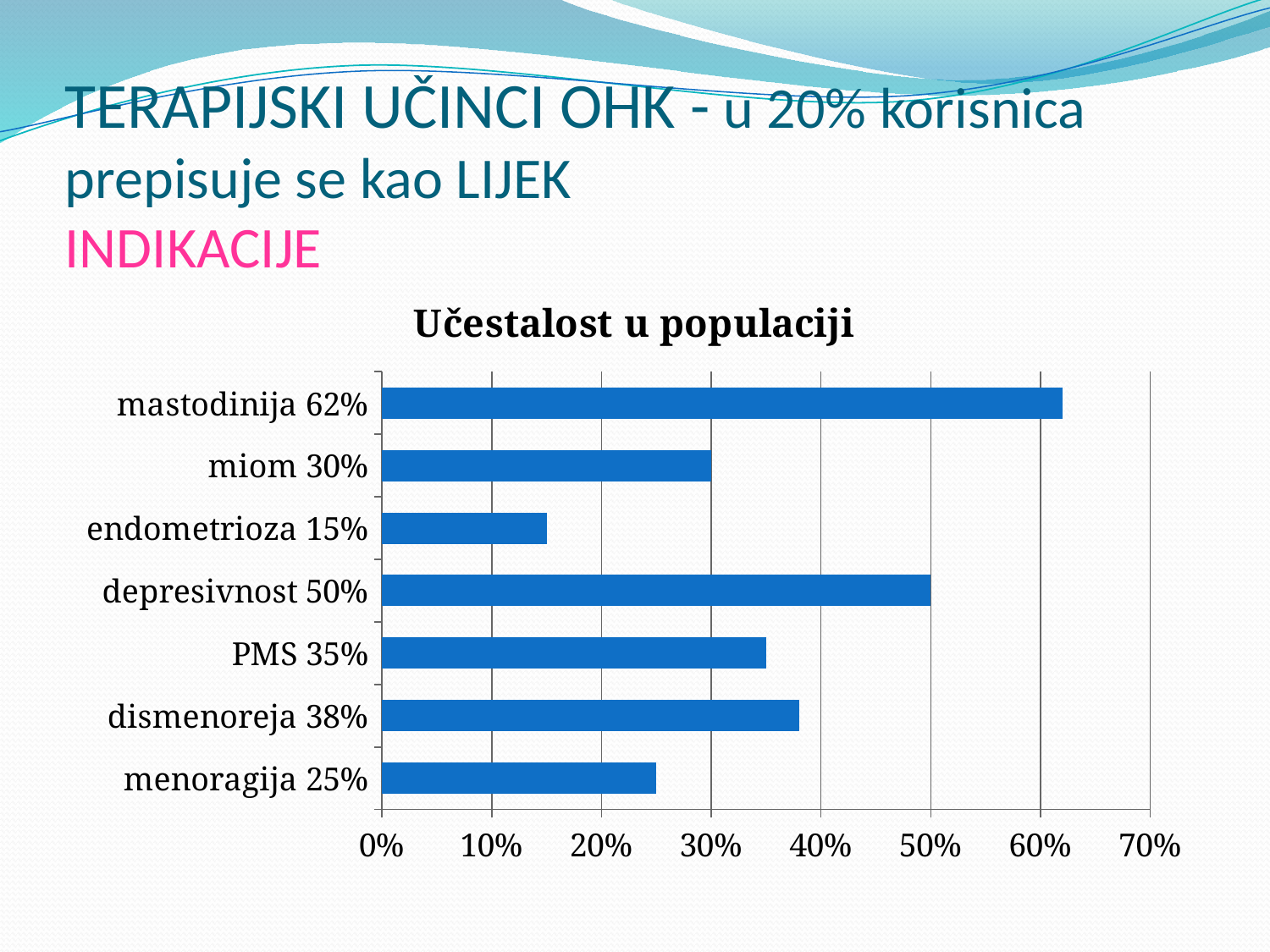
What is the value for endometrioza? 15% What is the difference between the values for dismenoreja and PMS? 3% What is the title of the chart? Učestalost u populaciji Is the value for depresivnost greater or less than 40%? greater Which category has the lowest value? endometrioza How many categories are shown in the chart? 7 Which category has the highest value? mastodinija Which is larger, the value for PMS or the value for menoragija? PMS What kind of chart is shown on the slide? bar chart What is the value for dismenoreja? 38% What is the difference between the values for depresivnost and miom? 20% What is the value for mastodinija? 62%